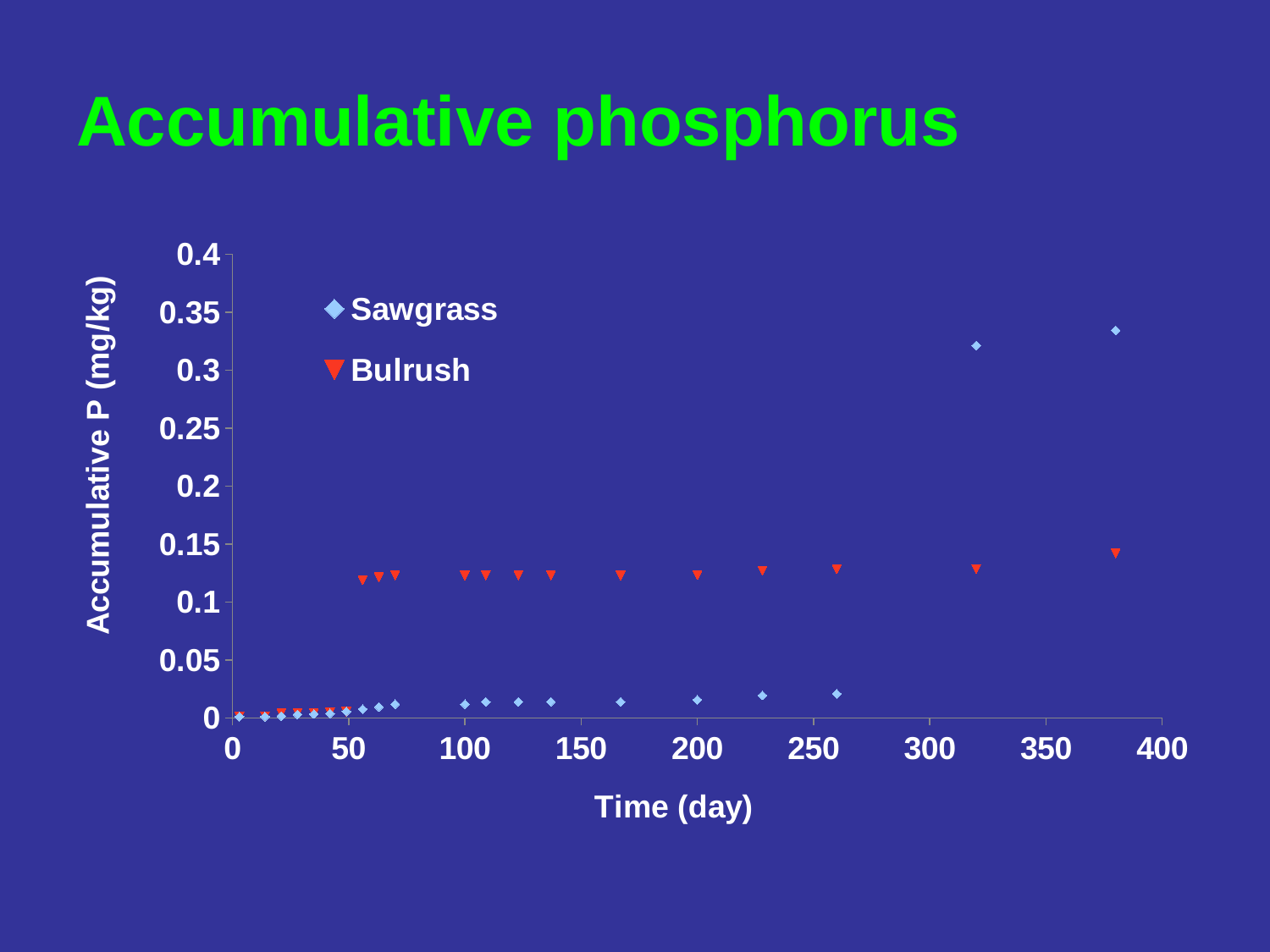
What kind of chart is shown on the slide? scatter chart Is the Bulrush value at about day 380 greater or less than 0.15? less How many series does the legend list? 2 Which series reaches the highest accumulative P value on the chart? Sawgrass What is the label of the x axis? Time (day) At about day 200, which series has the higher accumulative P value, Sawgrass or Bulrush? Bulrush At about day 380, which series has the higher accumulative P value, Sawgrass or Bulrush? Sawgrass Is the Sawgrass value at about day 380 greater or less than 0.3? greater Do the Sawgrass values rise or fall as time increases? rise Is the Sawgrass value at about day 260 greater or less than 0.05? less What is the title of the chart? Accumulative phosphorus